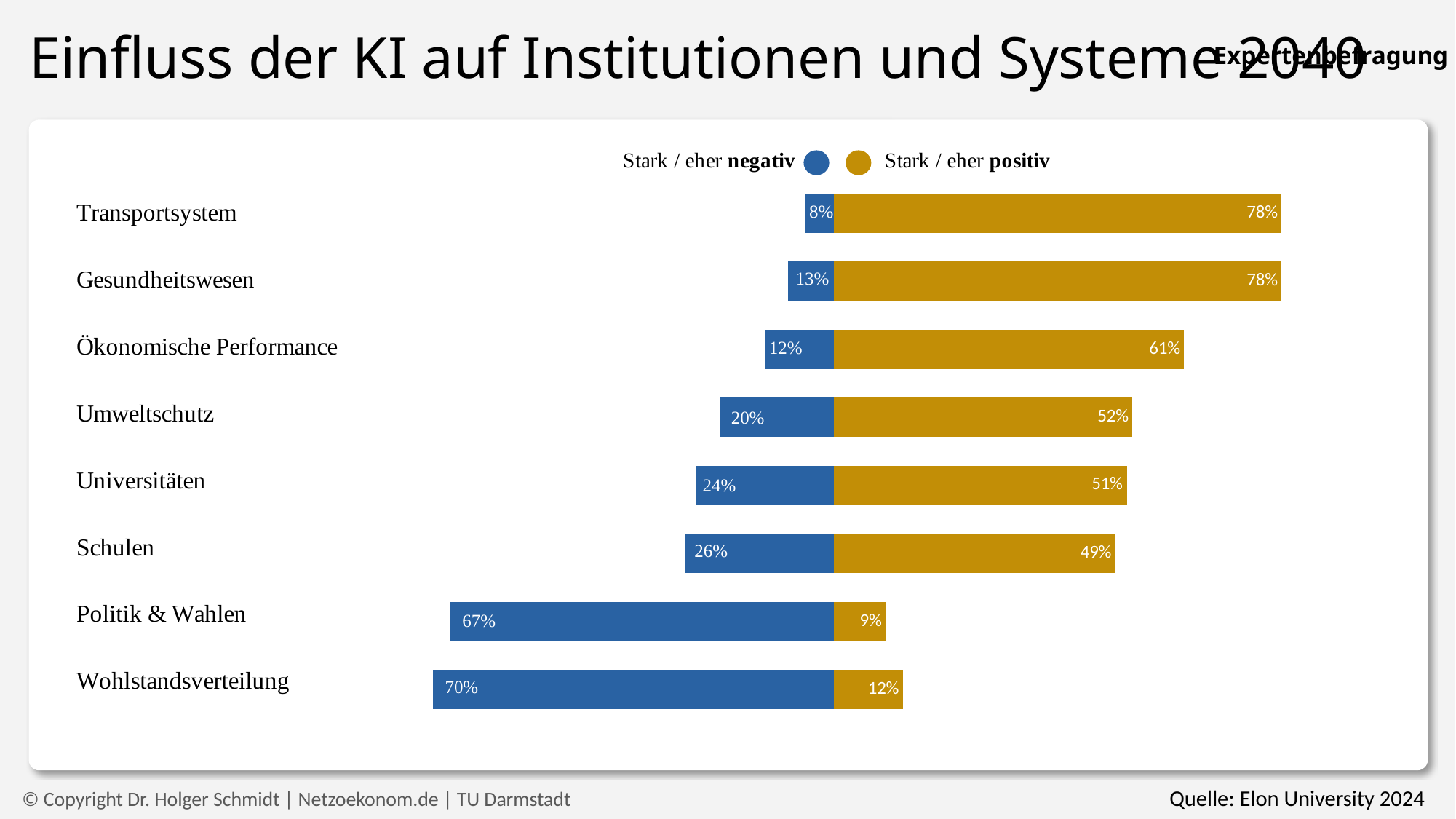
What type of chart is shown on the slide? Bar chart Which category has the lowest 'Stark / eher negativ' value? Transportsystem What is the 'Stark / eher negativ' value for Wohlstandsverteilung? 70% What is the 'Stark / eher negativ' value for Schulen? 26% Which is larger for Universitäten: the 'Stark / eher negativ' value or the 'Stark / eher positiv' value? Stark / eher positiv What is the 'Stark / eher positiv' value for Ökonomische Performance? 61% What is the difference between the 'Stark / eher positiv' and 'Stark / eher negativ' values for Umweltschutz? 32% How many categories are shown in the chart? 8 Which category has the lowest 'Stark / eher positiv' value? Politik & Wahlen What is the 'Stark / eher positiv' value for Transportsystem? 78% How many series does the legend list? 2 Which category has the highest 'Stark / eher negativ' value? Wohlstandsverteilung